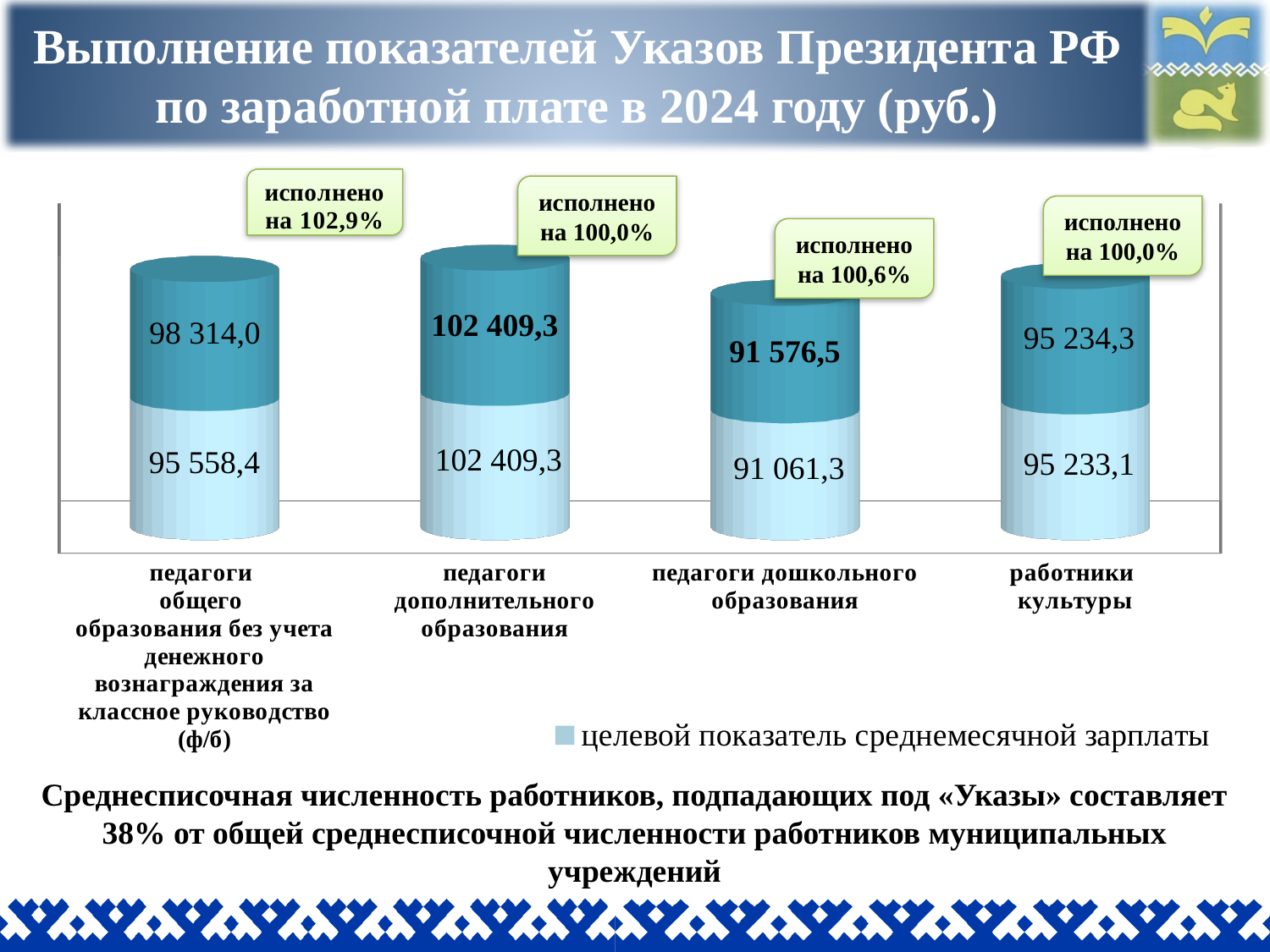
For педагоги дошкольного образования, what is the difference between the upper dark-blue value (91 576,5) and the target value (91 061,3)? 515,2 What value is printed in the upper dark-blue segment for педагоги общего образования без учета денежного вознаграждения за классное руководство (ф/б)? 98 314,0 For педагоги общего образования, what is the difference between the upper dark-blue value (98 314,0) and the target value (95 558,4)? 2 755,6 Which category has the lowest target average monthly salary (целевой показатель)? педагоги дошкольного образования What is the target average monthly salary (целевой показатель, light-blue segment) for педагоги дошкольного образования? 91 061,3 What value is printed in the upper dark-blue segment for работники культуры? 95 234,3 What is the target average monthly salary (целевой показатель) for педагоги дополнительного образования? 102 409,3 How many categories are shown on the chart? 4 Which category has the highest target average monthly salary (целевой показатель)? педагоги дополнительного образования Which is larger: the target salary for педагоги общего образования (95 558,4) or for педагоги дошкольного образования (91 061,3)? педагоги общего образования According to the callout above the bar, by what percentage was the indicator fulfilled for педагоги дошкольного образования? 100,6% What kind of chart is shown on the slide? bar chart